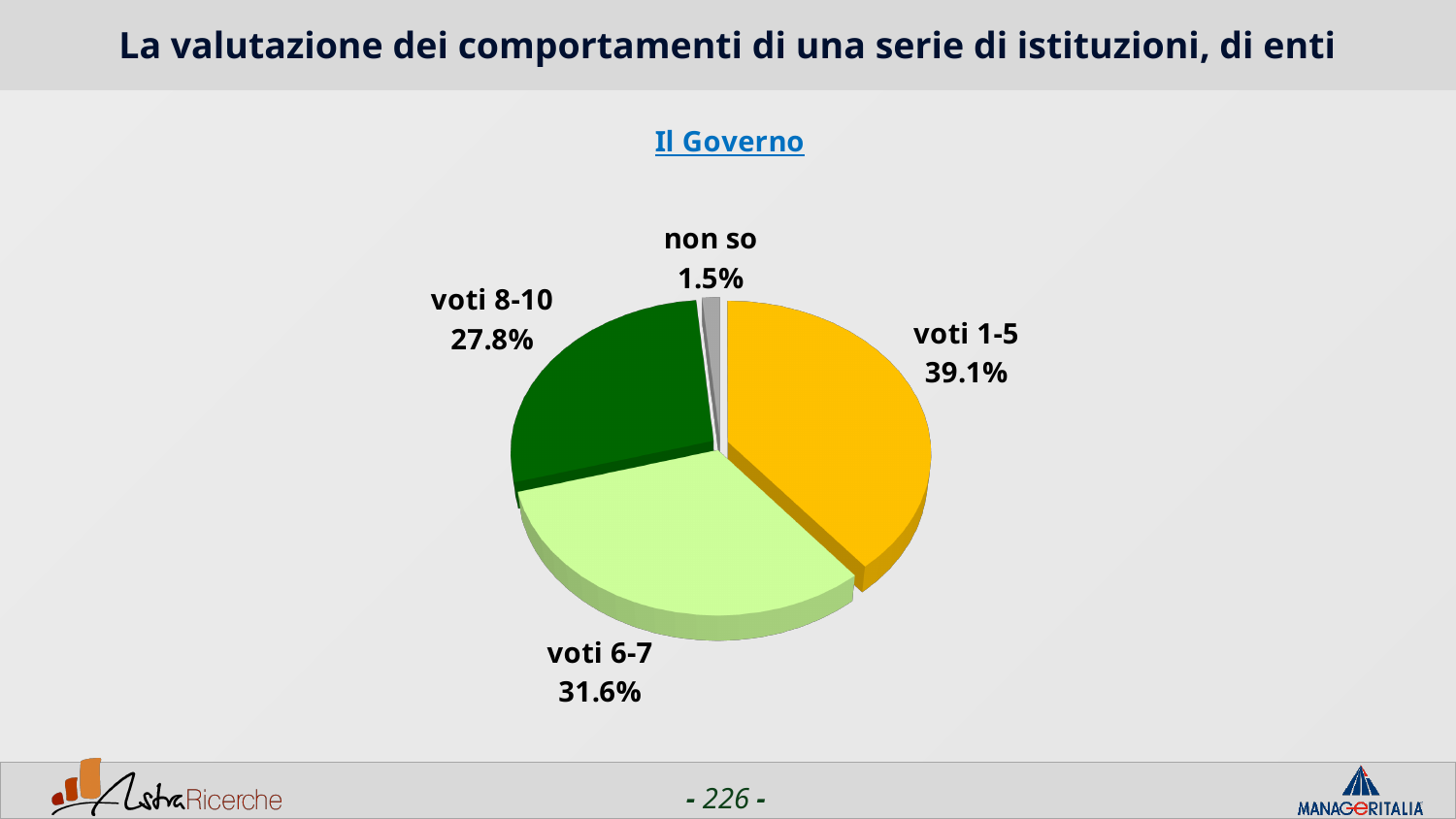
What kind of chart is shown on the slide? Pie chart What share of the pie is labelled "voti 6-7"? 31.6% What is the difference in percentage points between the "voti 1-5" and "voti 8-10" slices? 11.3 What is the title of the chart? Il Governo Which slice is larger, "voti 6-7" or "voti 8-10"? voti 6-7 What colour is the "voti 1-5" slice? Yellow/orange What share of the pie is labelled "non so"? 1.5% How many slices does the pie chart have? 4 Which slice of the pie is the smallest? non so What share of the pie is labelled "voti 1-5"? 39.1% Which slice of the pie is the largest? voti 1-5 What share of the pie is labelled "voti 8-10"? 27.8%